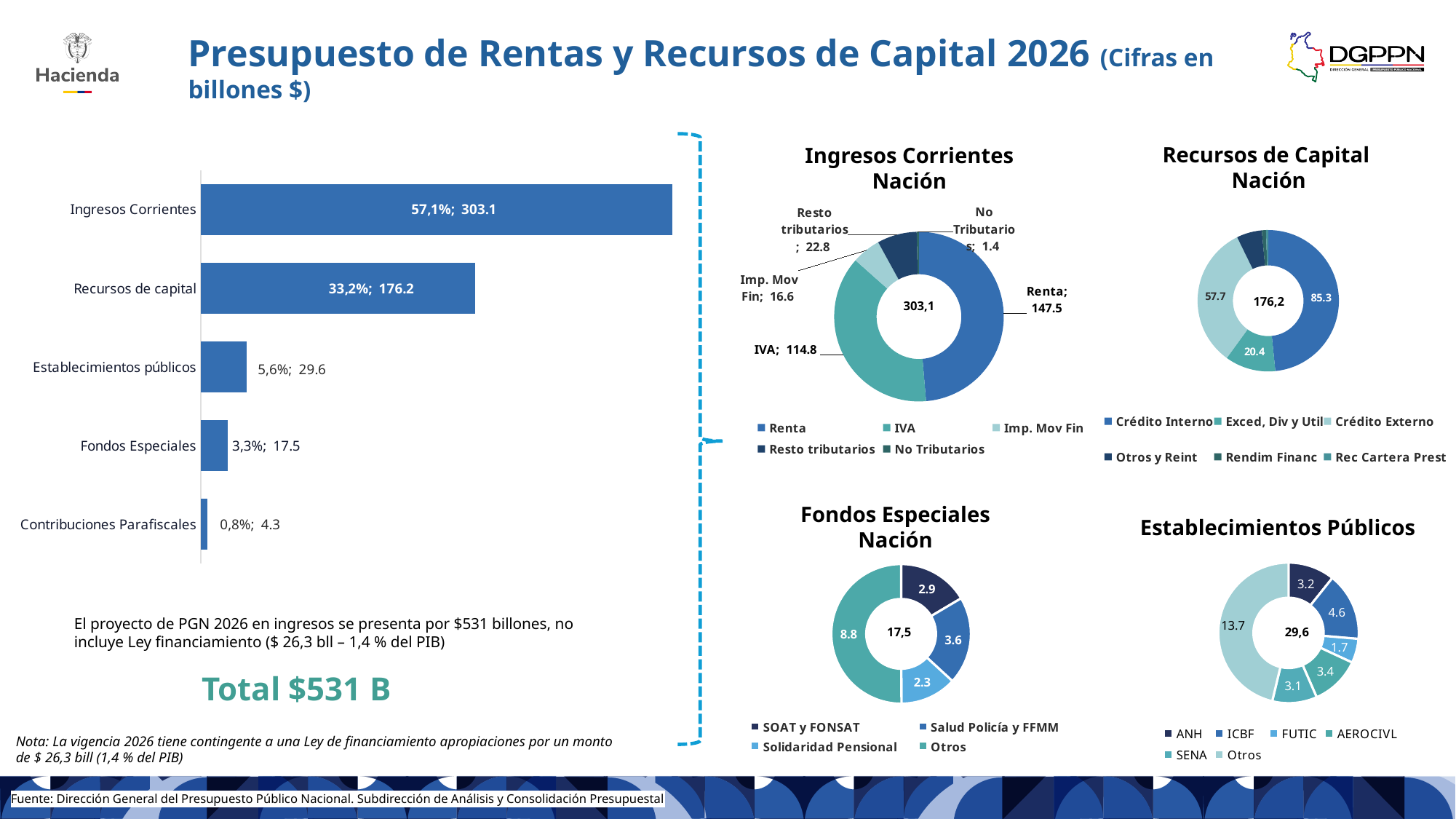
In the 'Establecimientos Públicos' chart, what is the value for ICBF? 4.6 In the bar chart on the left, what percentage is shown for Establecimientos públicos? 5,6% In the 'Ingresos Corrientes Nación' chart, what is the difference between Renta and IVA? 32.7 In the 'Ingresos Corrientes Nación' chart, what is the value for Renta? 147.5 What kind of chart is the chart on the left of the slide? Bar chart In the bar chart on the left, which category has the lowest value? Contribuciones Parafiscales In the 'Ingresos Corrientes Nación' chart, which category has the smallest value? No Tributarios In the bar chart on the left, which category has the highest value? Ingresos Corrientes How many categories does the bar chart on the left show? 5 How many entries does the legend of the 'Recursos de Capital Nación' chart list? 6 In the bar chart on the left, what value is shown for Recursos de capital? 176.2 In the 'Fondos Especiales Nación' chart, which is larger: Salud Policía y FFMM or SOAT y FONSAT? Salud Policía y FFMM